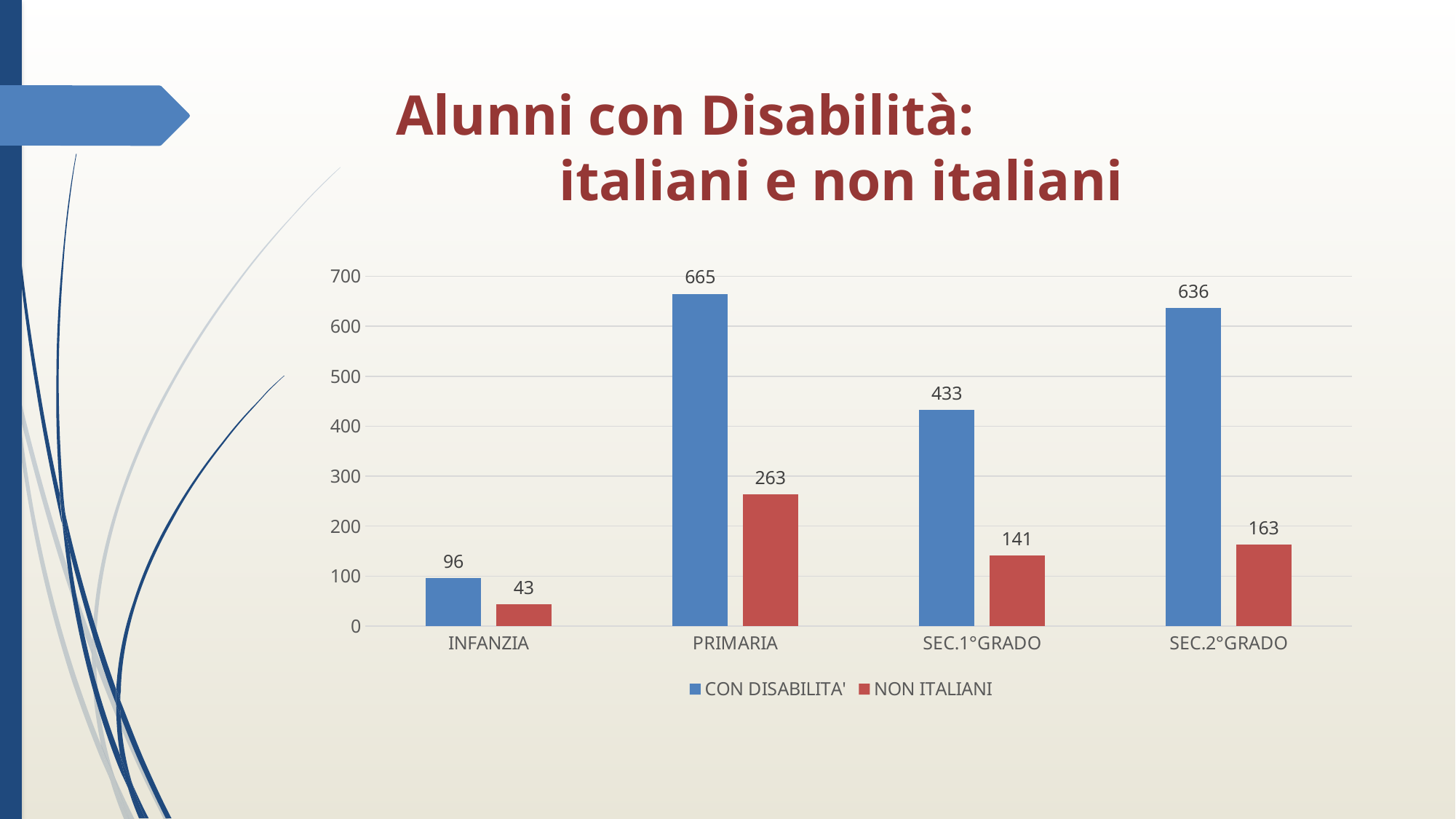
Is the value for CON DISABILITA' in SEC.1°GRADO greater or less than 400? greater What is the value for NON ITALIANI in INFANZIA? 43 Which category has the lowest value for NON ITALIANI? INFANZIA What is the difference between CON DISABILITA' and NON ITALIANI in SEC.2°GRADO? 473 How many series does the legend list? 2 Which colour represents the NON ITALIANI series? red How many categories are shown on the x axis? 4 Which is larger: NON ITALIANI in PRIMARIA or NON ITALIANI in SEC.2°GRADO? NON ITALIANI in PRIMARIA What is the value for CON DISABILITA' in PRIMARIA? 665 Which category has the highest value for CON DISABILITA'? PRIMARIA What is the value for NON ITALIANI in SEC.1°GRADO? 141 What kind of chart is shown on the slide? bar chart